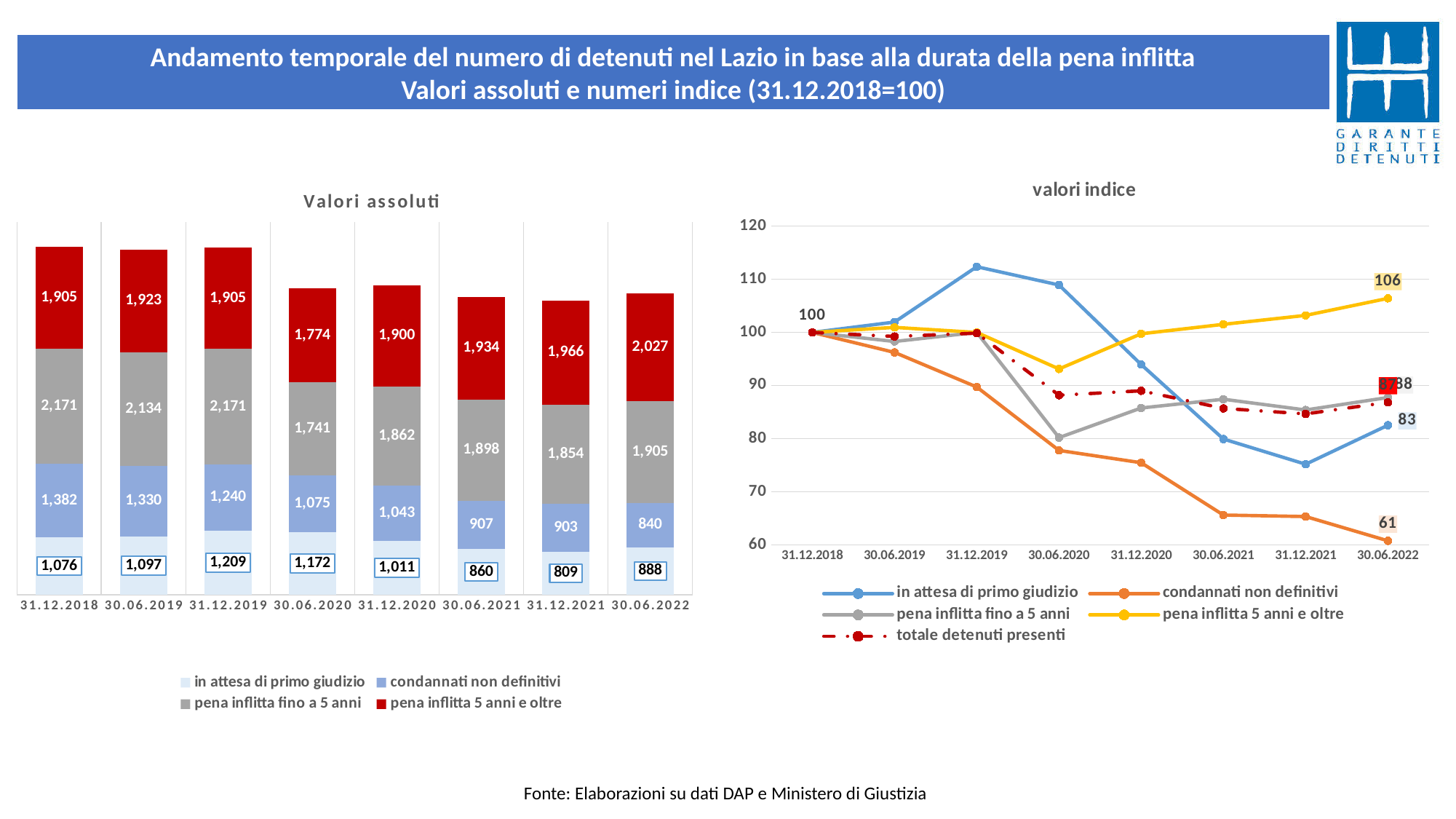
In the 'Valori assoluti' chart, what is the value for 'pena inflitta 5 anni e oltre' at 30.06.2022? 2,027 In the 'Valori assoluti' chart, what is the difference between the 'pena inflitta fino a 5 anni' values at 31.12.2018 and 30.06.2020? 430 What kind of chart is the 'Valori assoluti' chart on the left? bar chart In the 'Valori assoluti' chart, what is the value for 'in attesa di primo giudizio' at 31.12.2019? 1,209 How many dates are shown on the x axis of the 'Valori assoluti' chart? 8 In the 'Valori assoluti' chart, at which date is the 'in attesa di primo giudizio' value lowest? 31.12.2021 How many series does the legend of the 'Valori assoluti' chart list? 4 In the 'valori indice' chart, is the value for 'condannati non definitivi' at 30.06.2021 greater or less than 70? less How many series does the legend of the 'valori indice' chart list? 5 In the 'Valori assoluti' chart, what is the total of the stacked bar for 31.12.2018? 6,534 In the 'valori indice' chart, what is the value for 'condannati non definitivi' at 30.06.2022? 61 In the 'valori indice' chart, does the 'condannati non definitivi' line rise or fall from 31.12.2018 to 30.06.2022? fall